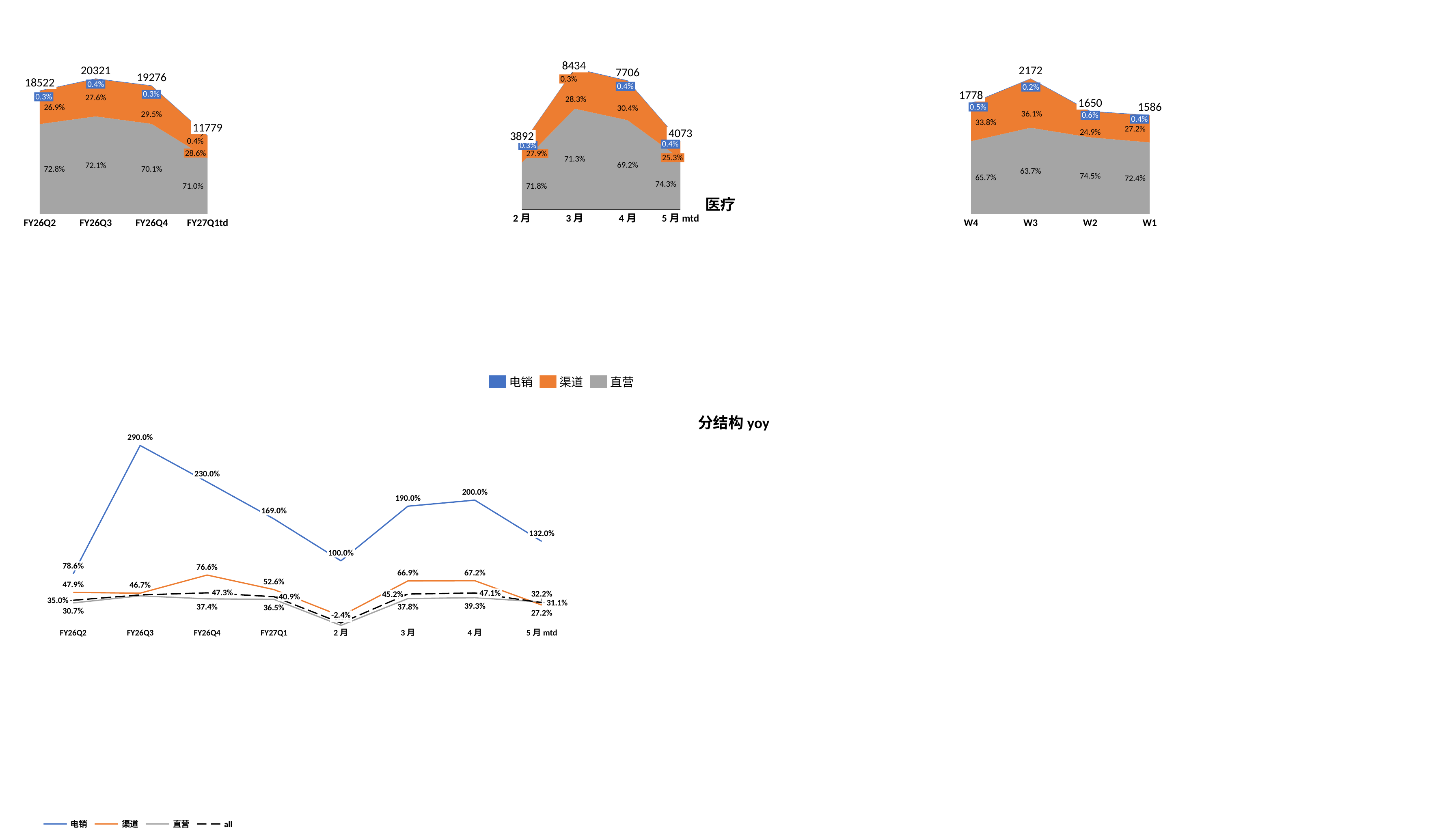
In the bottom chart titled 分结构 yoy, how many series does the legend list? 4 In the top-left chart (FY26Q2 to FY27Q1td), what is the 直营 share for FY26Q4? 70.1% In the top-middle chart (2月 to 5月 mtd), what is the difference between the totals for 3月 and 4月? 728 In the bottom chart titled 分结构 yoy, what is the 电销 value for FY26Q3? 290.0% What kind of chart is the bottom chart titled 分结构 yoy? line chart In the top-right chart (W4 to W1), which is larger, the 渠道 share for W3 or for W2? W3 In the top-right chart (W4 to W1), which week has the highest total value? W3 In the top-middle chart (2月 to 5月 mtd), what is the 渠道 share for 4月? 30.4% In the top-left chart (FY26Q2 to FY27Q1td), what is the total value shown for FY26Q3? 20321 In the top-right chart (W4 to W1), what is the 直营 share for W2? 74.5% In the top-middle chart (2月 to 5月 mtd), what is the total value shown for 3月? 8434 In the top-left chart (FY26Q2 to FY27Q1td), which period has the lowest total value? FY27Q1td